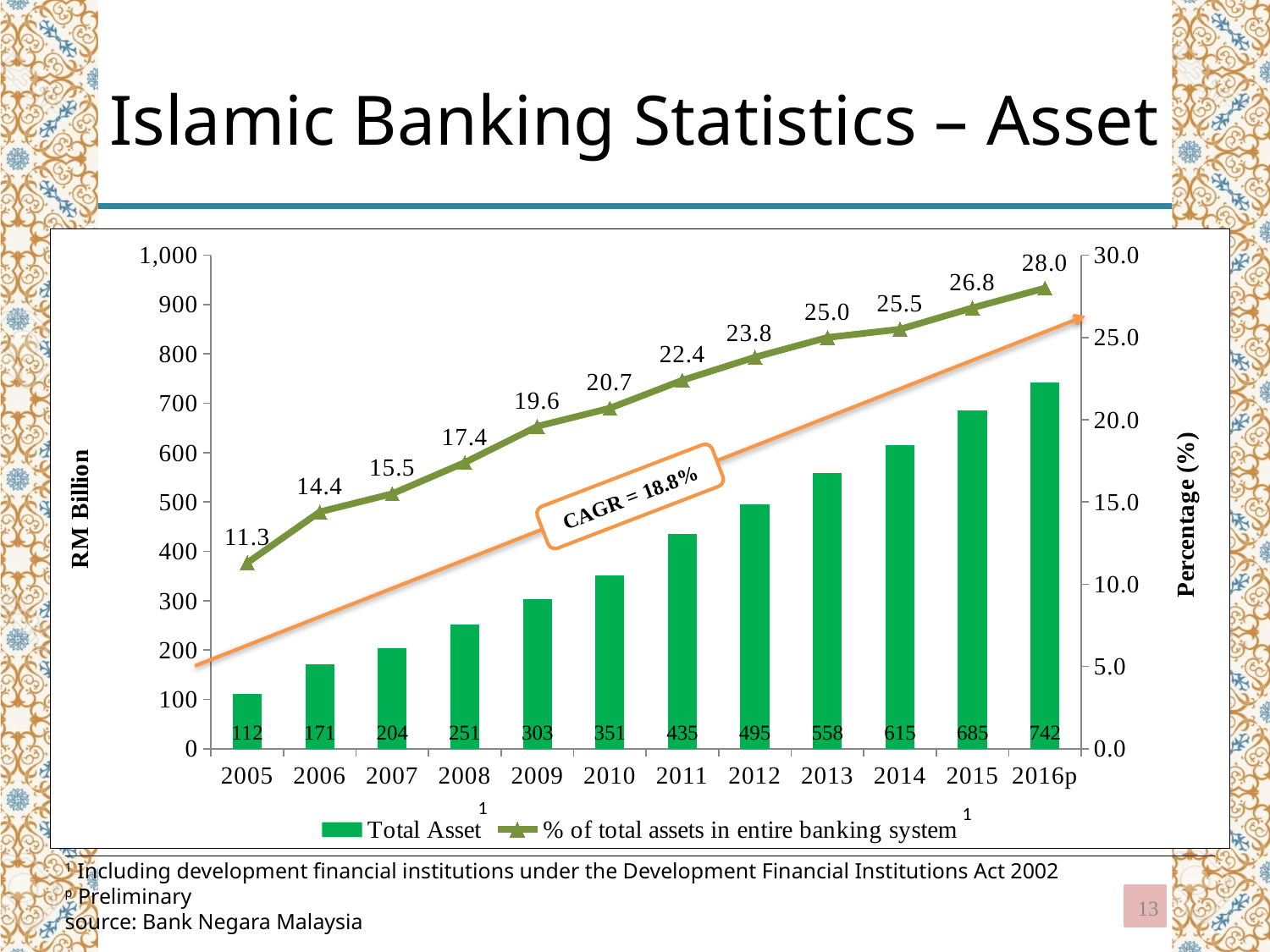
How many years are shown on the x axis? 12 What is the Total Asset value for 2010? 351 Which year has the highest Total Asset value? 2016p What CAGR is shown on the chart? 18.8% What is the label of the left vertical axis? RM Billion What kind of chart is this? Combined bar and line chart What is the difference in Total Asset between 2016p and 2015? 57 Which year has the lowest % of total assets in entire banking system? 2005 Do the Total Asset values rise or fall from 2005 to 2016p? Rise How many series does the legend list? 2 What is the % of total assets in entire banking system for 2013? 25.0 Which is larger, the Total Asset for 2008 or for 2009? 2009